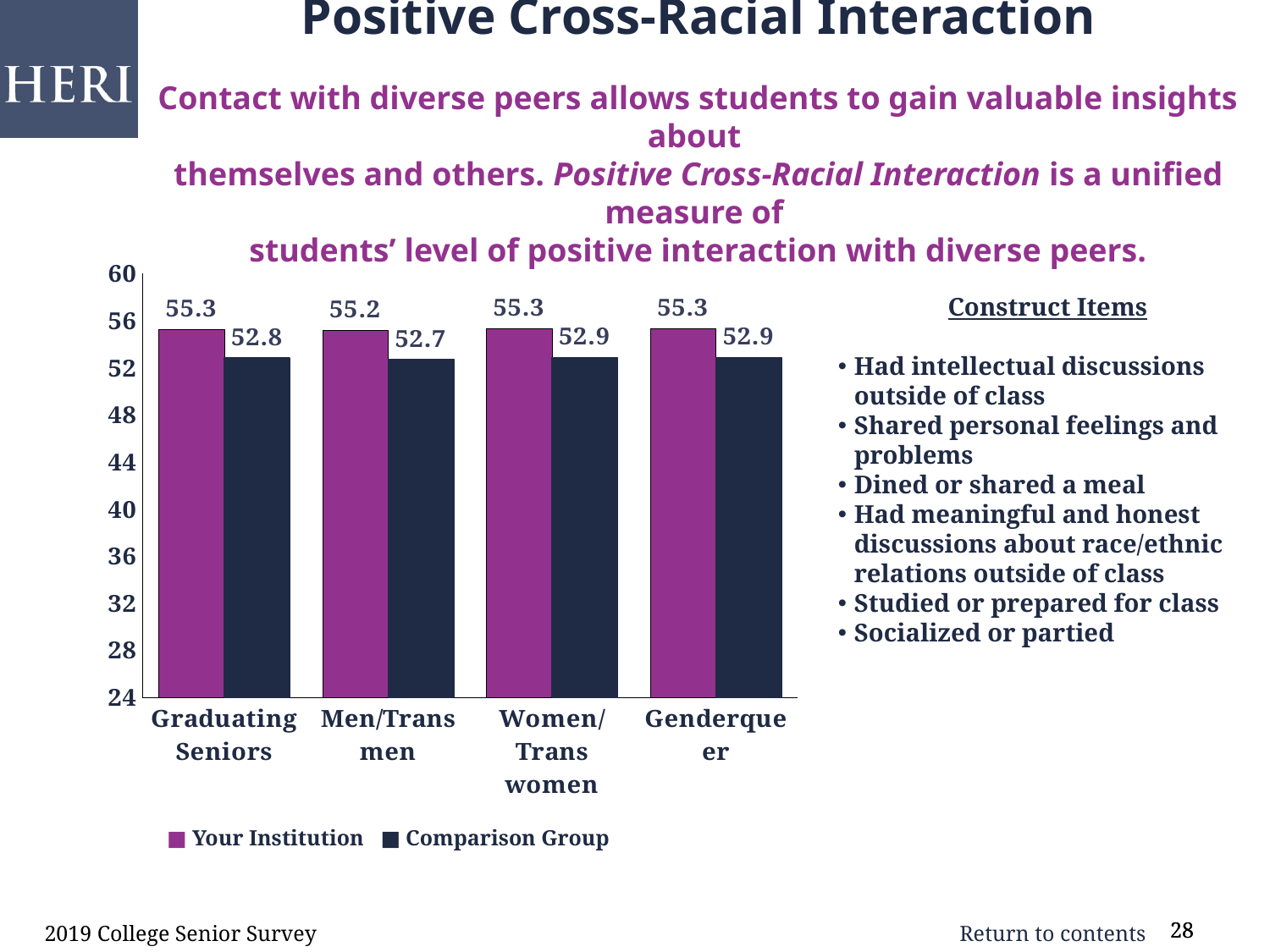
How many series does the legend list? 2 What is the difference between the Your Institution and Comparison Group values for Graduating Seniors? 2.5 What is the Your Institution value for Genderqueer? 55.3 What is the Comparison Group value for Men/Trans men? 52.7 What is the difference between the Your Institution and Comparison Group values for Genderqueer? 2.4 How many categories are shown on the x axis? 4 For Women/Trans women, which is larger: the Your Institution value or the Comparison Group value? Your Institution Which series is shown in purple in the legend? Your Institution What is the Comparison Group value for Women/Trans women? 52.9 Which category has the lowest Your Institution value? Men/Trans men What is the Your Institution value for Graduating Seniors? 55.3 What kind of chart is shown on the slide? bar chart